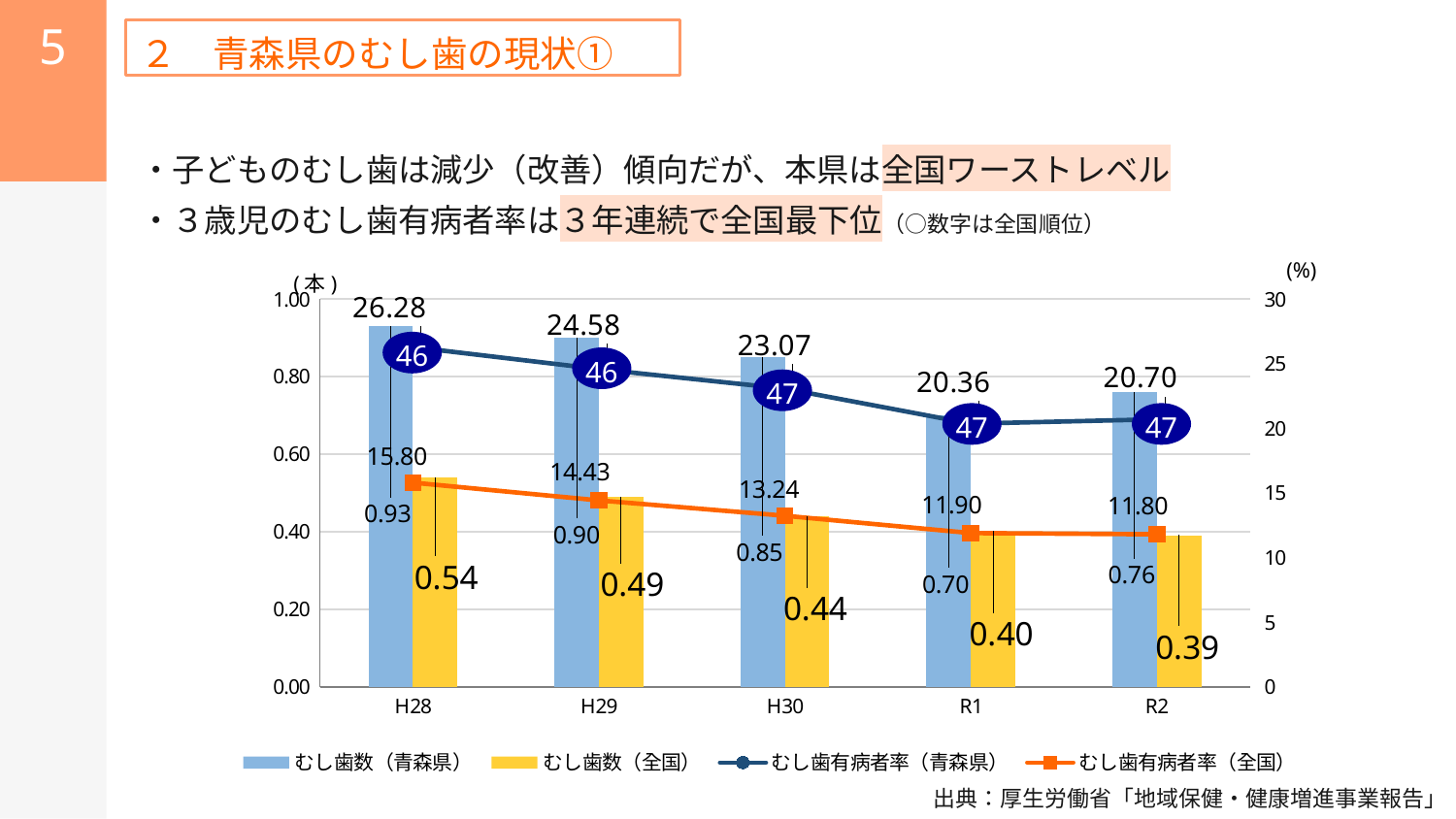
In which year is むし歯有病者率（青森県） highest? H28 Which is larger in R2: むし歯数（青森県） or むし歯数（全国）? むし歯数（青森県） How many years are shown on the x axis? 5 What is the value of むし歯数（全国） for R1? 0.40 What is the value of むし歯数（青森県） for H28? 0.93 How many series does the legend list? 4 What is the value of むし歯有病者率（青森県） for H30? 23.07 What national rank (number in the circle) is shown for R1? 47 Does むし歯有病者率（全国） rise or fall from H28 to R2? fall What is the value of むし歯有病者率（全国） for R2? 11.80 What is the difference between むし歯有病者率（青森県） and むし歯有病者率（全国） in H28? 10.48 In which year is むし歯数（青森県） lowest? R1